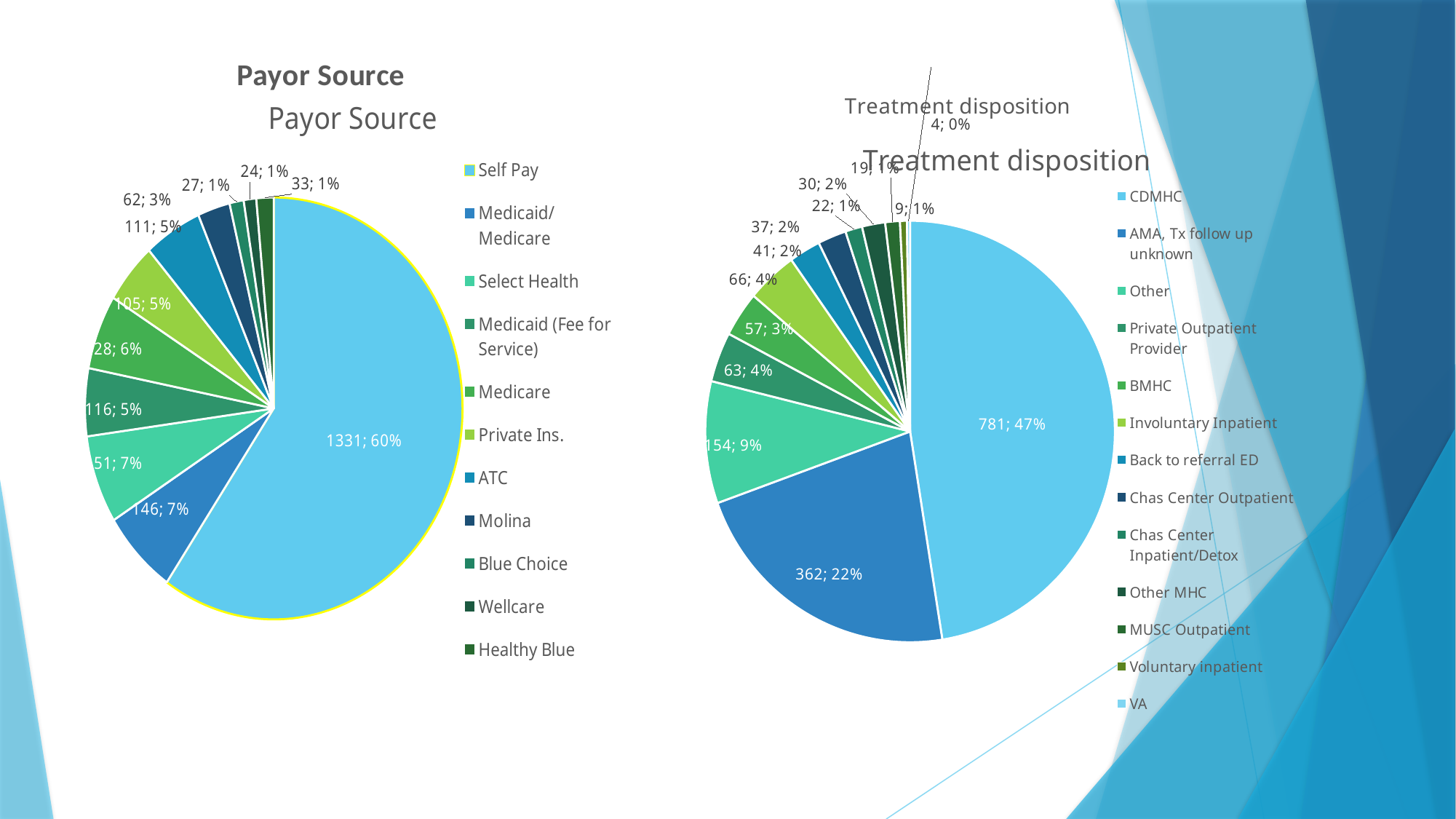
How many entries does the legend of the Payor Source chart list? 11 In the Payor Source chart, what percentage share is shown for Medicare? 6% In the Treatment disposition chart, what is the difference between the CDMHC value and the AMA, Tx follow up unknown value? 419 In the Treatment disposition chart, what value and share are shown for CDMHC? 781; 47% In the Payor Source chart, which is larger, the value for Select Health or the value for Medicaid/Medicare? Select Health In the Treatment disposition chart, which category has the smallest slice? VA In the Payor Source chart, what value and share are shown for Self Pay? 1331; 60% In the Payor Source chart, which payor source has the largest slice? Self Pay In the Payor Source chart, what is the value shown for Molina? 62 In the Treatment disposition chart, what is the value shown for AMA, Tx follow up unknown? 362 How many categories does the legend of the Treatment disposition chart list? 13 What type of chart is used for Treatment disposition? Pie chart